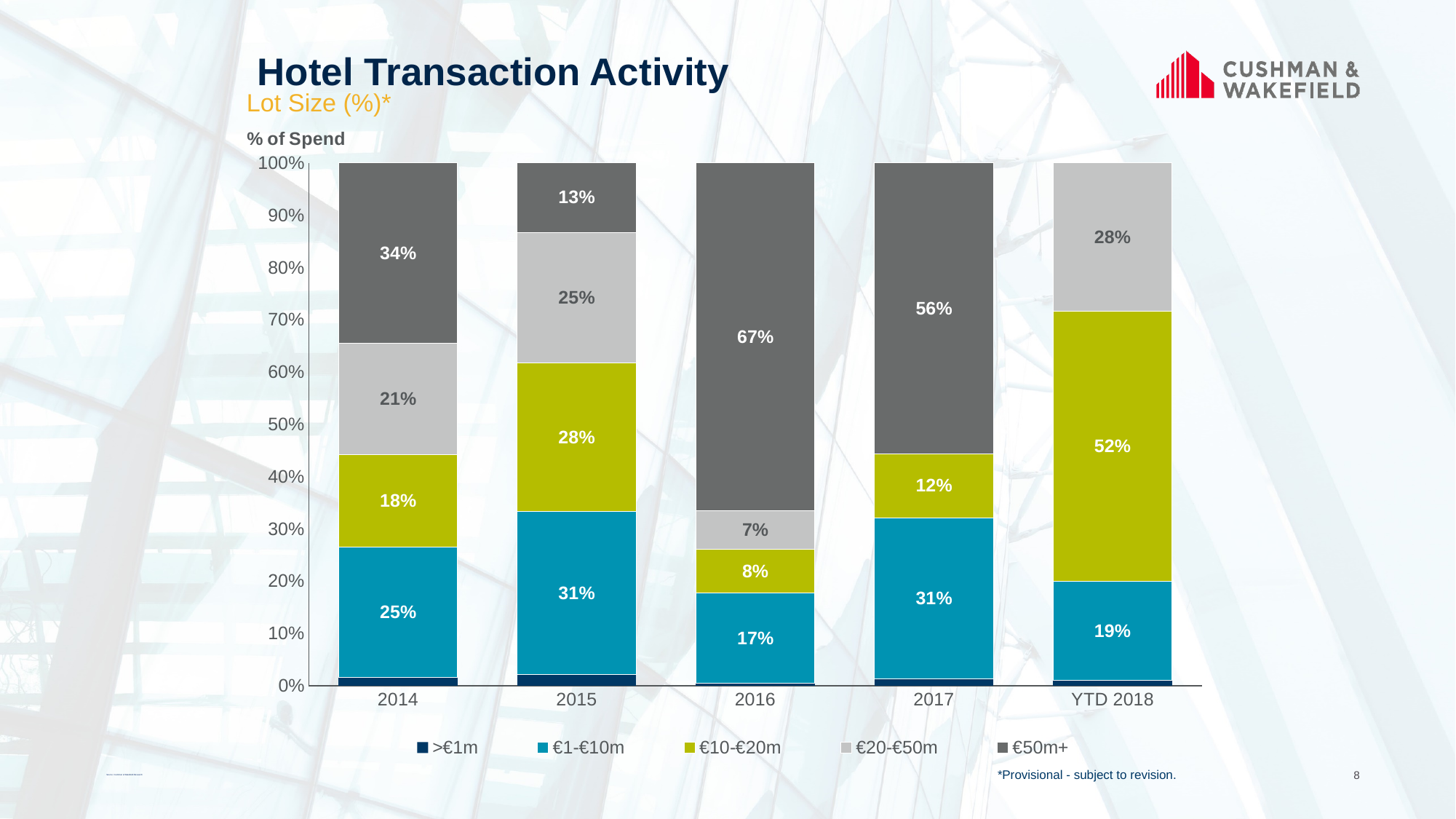
In which year is the €50m+ share of spend highest? 2016 What is the difference between the €50m+ share in 2017 and in 2015? 43% What is the €1-€10m share of spend in 2017? 31% What is the €50m+ share of spend in 2016? 67% What is the €20-€50m share of spend in 2015? 25% What type of chart is shown on the slide? stacked bar chart How many series does the legend list? 5 What is the €10-€20m share of spend in YTD 2018? 52% How many year categories are shown on the x axis? 5 In which year is the €1-€10m share of spend lowest? 2016 Which is larger, the €10-€20m share in 2014 or in 2015? 2015 What is the subtitle of the chart below the title 'Hotel Transaction Activity'? Lot Size (%)*